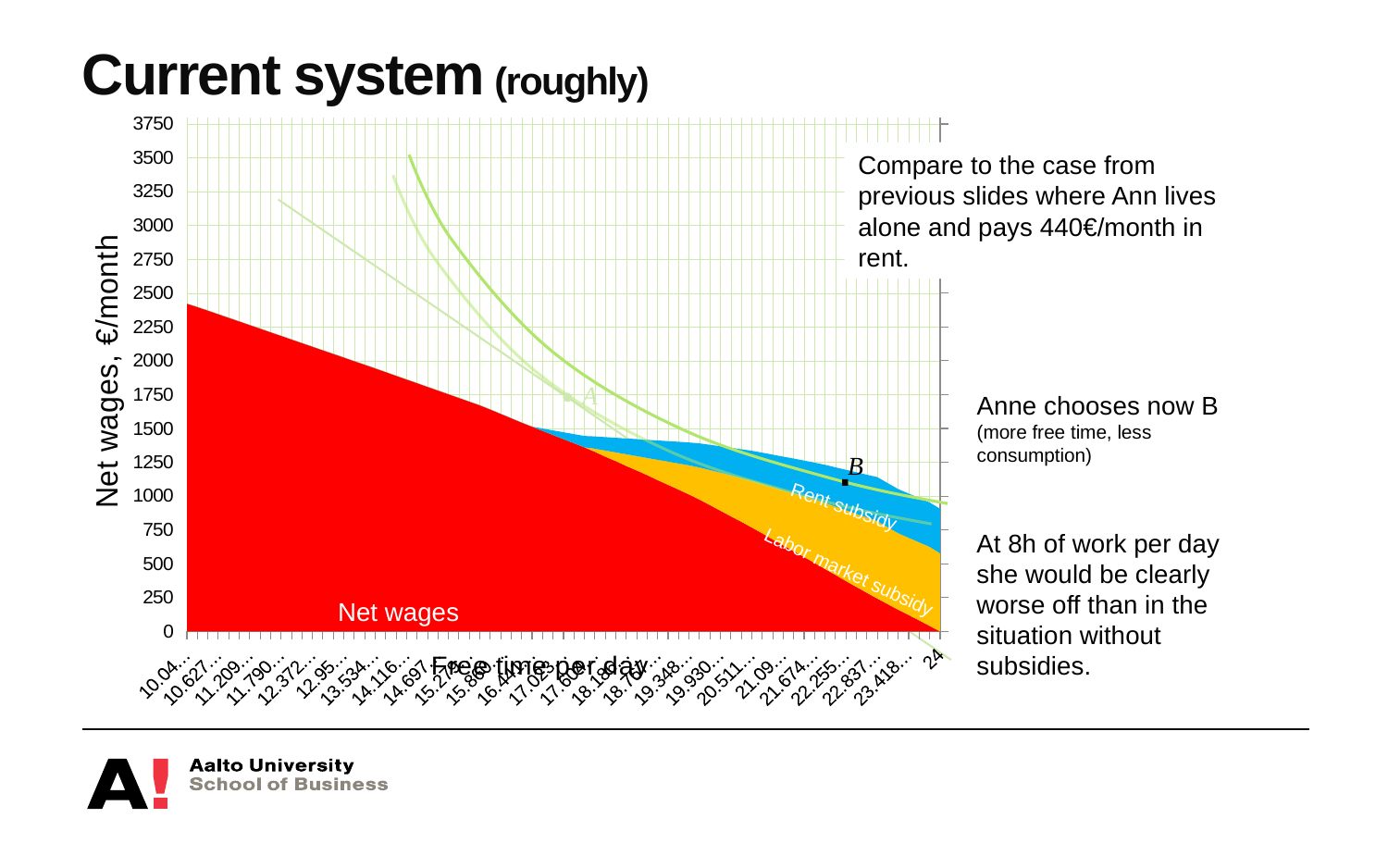
What is the title of the chart's vertical axis? Net wages, €/month Do net wages rise or fall as free time per day increases? fall Is the value at point B greater or less than 1250? less What is the highest value shown on the vertical axis? 3750 Is the value of Net wages at 10.04 hours of free time greater or less than 2500? less Which is larger at 10.04 hours of free time: Net wages or Rent subsidy? Net wages What is the title of the chart's horizontal axis? Free time per day Which series is shown in red at the bottom of the stack? Net wages Which series is stacked on top of the Labor market subsidy? Rent subsidy What kind of chart is shown on the slide? area chart How many series are plotted in the stacked area chart? 3 Is the value of Net wages at 10.04 hours of free time greater or less than 2250? greater